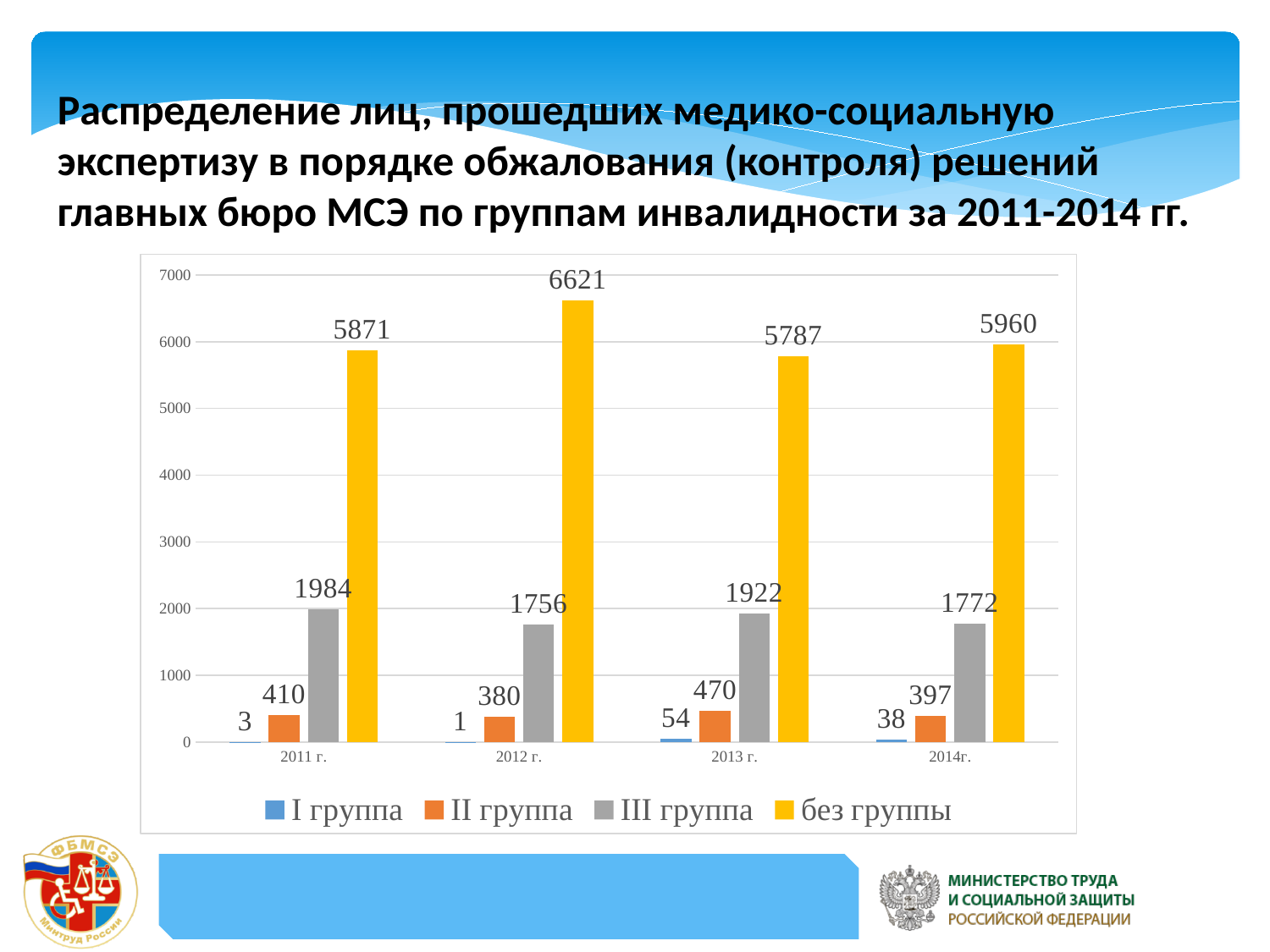
In which year is the value for "без группы" the highest? 2012 г. Which is larger: the "III группа" value in 2013 г. or in 2014г.? 2013 г. What is the value for "III группа" in 2011 г.? 1984 Which colour represents "без группы" in the legend? Yellow What kind of chart is shown on the slide? Bar chart How many years are shown on the x axis? 4 What is the value for "II группа" in 2013 г.? 470 What is the value for "I группа" in 2014г.? 38 What is the value for "без группы" in 2012 г.? 6621 How many series does the legend list? 4 What is the difference between the "без группы" values for 2012 г. and 2013 г.? 834 In which year is the value for "I группа" the lowest? 2012 г.